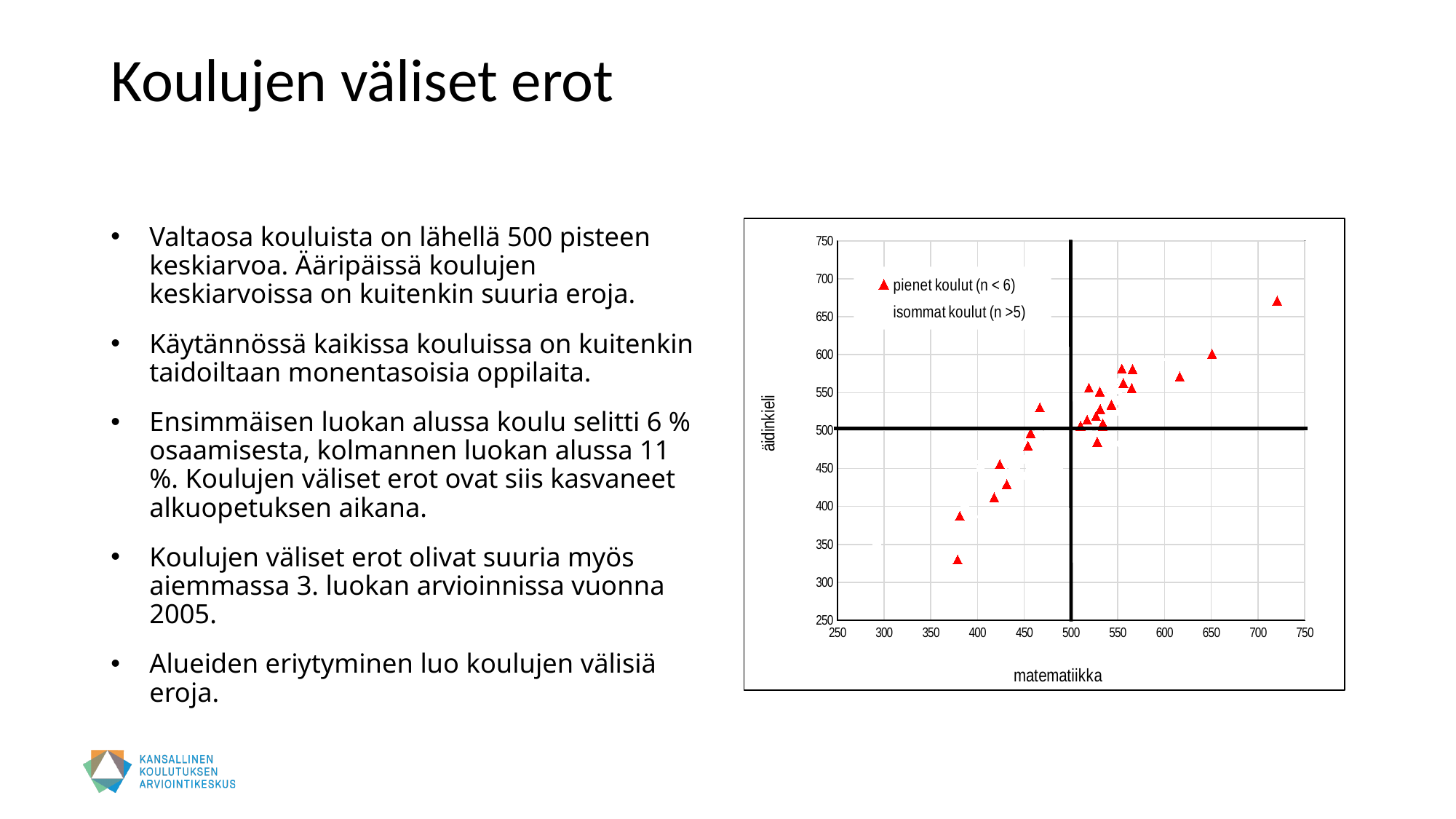
Is the matematiikka value of the point furthest to the left greater or less than 350? greater What is the highest value shown on the vertical axis of the chart? 750 What is the label of the vertical axis of the chart? äidinkieli Is the matematiikka value of the lowest point in the chart greater or less than 400? less Do the äidinkieli values generally rise or fall as the matematiikka values increase along the x axis? rise Is the äidinkieli value of the highest point in the chart greater or less than 650? greater What is the label of the horizontal axis of the chart? matematiikka What kind of chart is shown on the slide? scatter chart How many series does the chart's legend list? 2